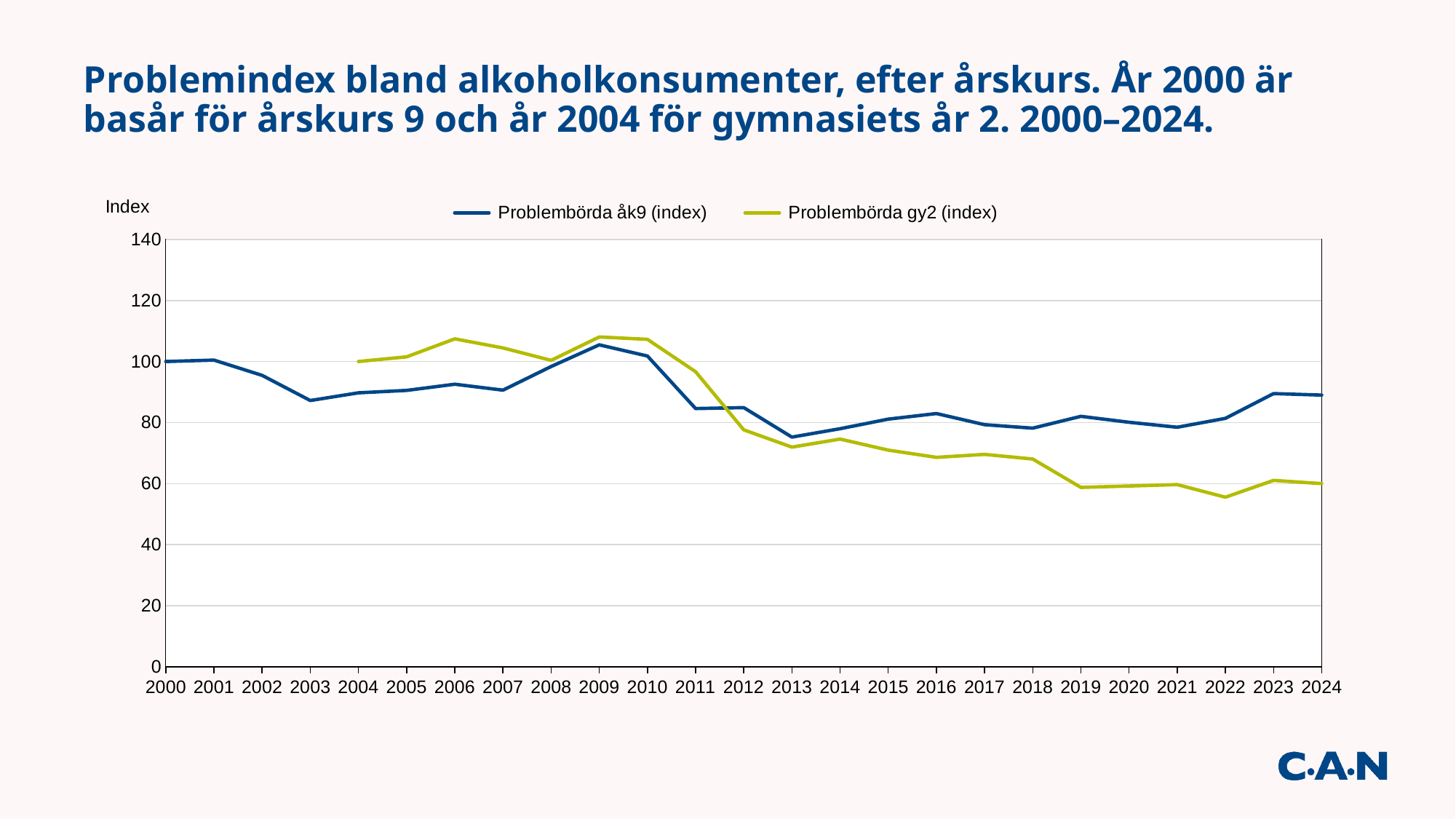
Is the value for Problembörda åk9 (index) in 2009 greater or less than 100? greater In 2020, which series has the higher value, Problembörda åk9 or Problembörda gy2? Problembörda åk9 (index) In which year does Problembörda gy2 (index) reach its lowest value? 2022 Is the value for Problembörda gy2 (index) in 2022 greater or less than 60? less Does Problembörda gy2 (index) rise or fall from 2010 to 2013? Fall What is the value of Problembörda åk9 (index) in 2000? 100 What is the value of Problembörda gy2 (index) in 2004? 100 What colour is the line for Problembörda gy2 (index)? Yellow-green How many series does the legend list? 2 Is the value for Problembörda gy2 (index) in 2013 greater or less than 80? less What kind of chart is shown on the slide? Line chart In 2006, which series has the higher value, Problembörda åk9 or Problembörda gy2? Problembörda gy2 (index)